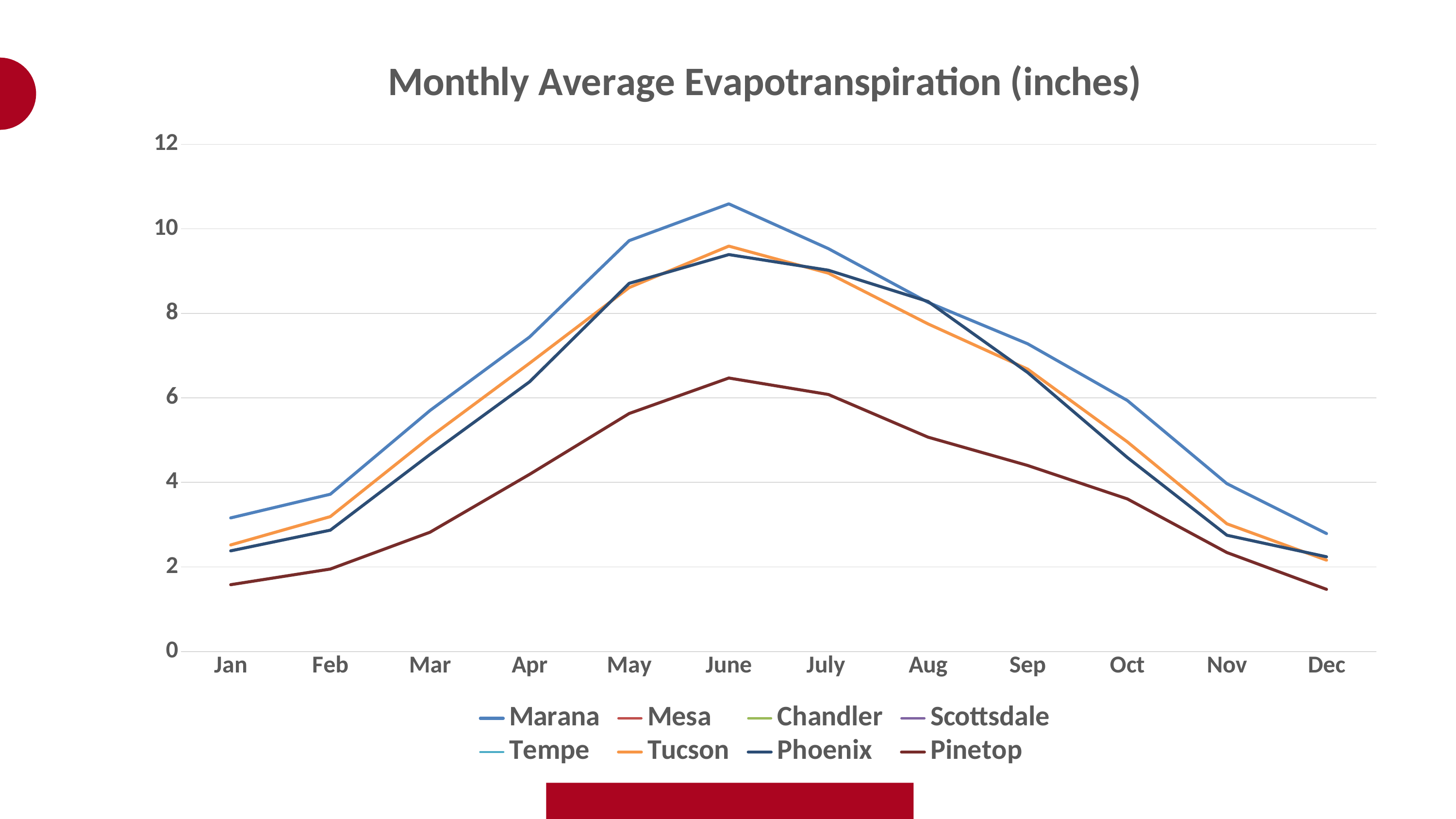
What kind of chart is shown on the slide? line chart Is the value for Phoenix in June greater or less than 8? greater In which month does the Phoenix line reach its highest value? June How many months are shown along the x axis? 12 Is the value for Pinetop in Jan greater or less than 2? less In which month does the Pinetop line reach its highest value? June Which series has the lowest value in June? Pinetop Which is larger in June, the value for Phoenix or the value for Pinetop? Phoenix What is the title of the chart? Monthly Average Evapotranspiration (inches) How many series does the legend list? 8 Does the Pinetop line rise or fall from June to Dec? fall Is the value for Pinetop in June greater or less than 6? greater